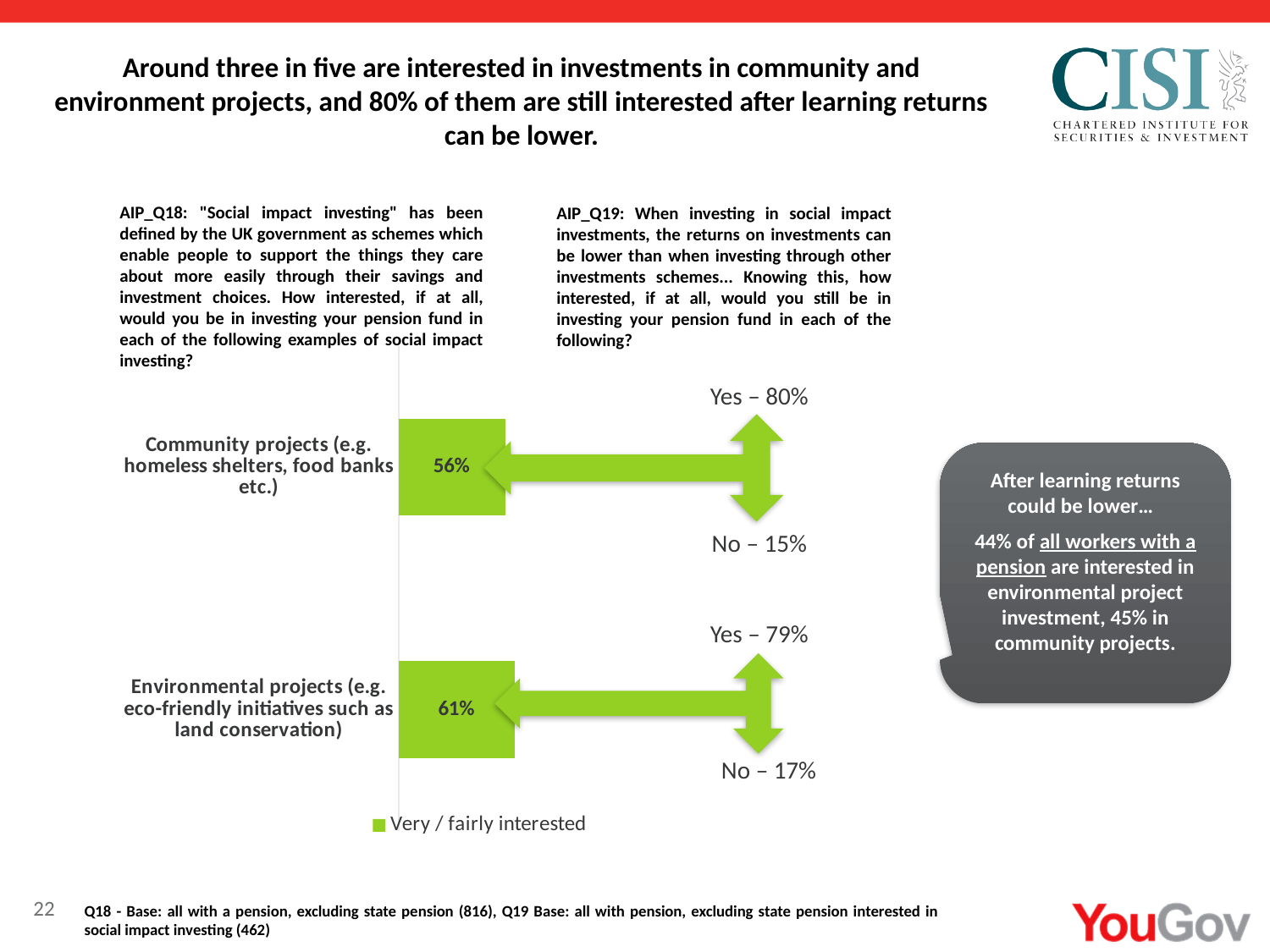
Is the value for community projects larger or smaller than the value for environmental projects? Smaller Which category has the higher share of respondents who are very or fairly interested: community projects or environmental projects? Environmental projects How many categories are shown in the bar chart? 2 According to the arrow annotation next to the environmental projects bar, what percentage would not still be interested (No) after learning returns could be lower? 17% What is the difference in percentage points between interest in environmental projects and interest in community projects? 5 percentage points What type of chart is used to show interest in community and environmental projects? Bar chart What percentage of respondents are very or fairly interested in investing their pension fund in community projects? 56% What percentage of respondents are very or fairly interested in investing their pension fund in environmental projects? 61% How many series does the chart legend list? 1 Which category has the lower share of respondents who are very or fairly interested? Community projects What is the legend entry for the green bars in the chart? Very / fairly interested According to the arrow annotation next to the community projects bar, what percentage would still be interested (Yes) after learning returns could be lower? 80%